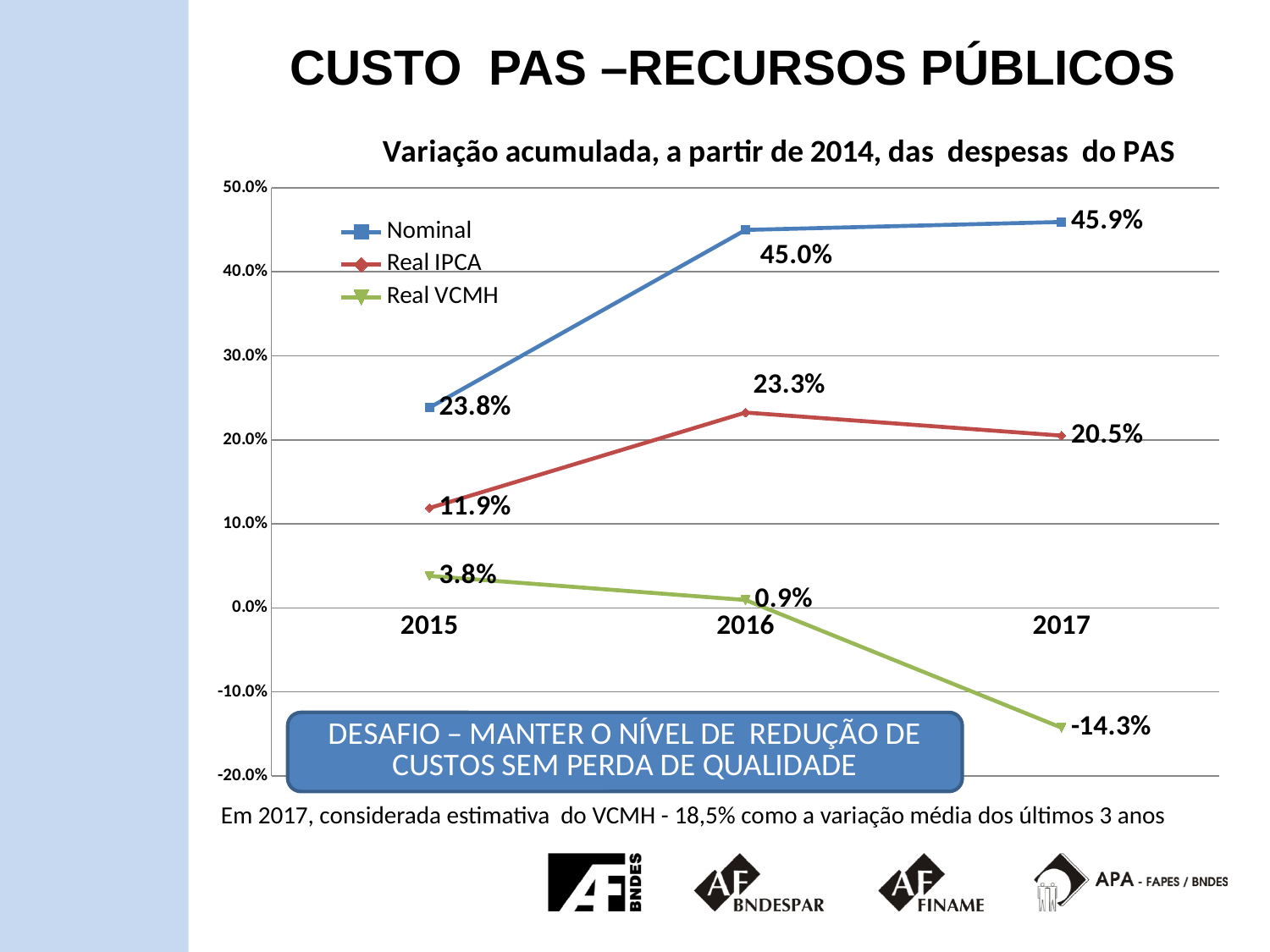
Does the Real VCMH series rise or fall from 2015 to 2017? Fall What is the value of the Nominal series in 2017? 45.9% What kind of chart is shown on the slide? Line chart How many years are shown on the x axis? 3 What is the value of the Real IPCA series in 2016? 23.3% In which year does the Real IPCA series reach its highest value? 2016 What is the value of the Real VCMH series in 2017? -14.3% How many series does the legend list? 3 What is the difference between the Nominal value in 2016 and the Nominal value in 2015? 21.2% What is the value of the Real VCMH series in 2015? 3.8% Which is larger in 2017: the Nominal value or the Real IPCA value? Nominal In which year does the Real VCMH series reach its lowest value? 2017